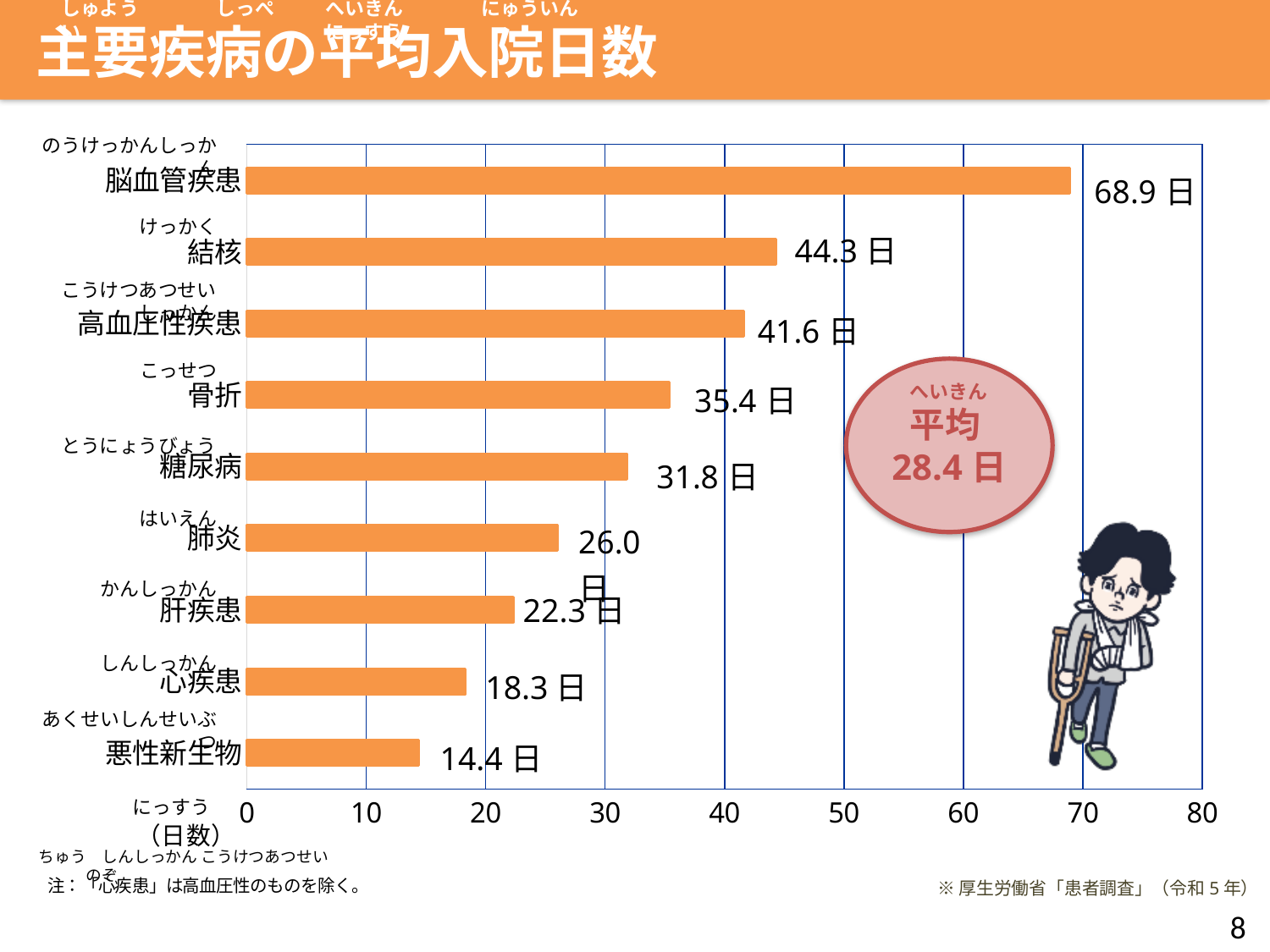
How many diseases are shown in the chart? 9 What is the average number of hospitalization days for 脳血管疾患? 68.9 日 What is the value shown for 骨折? 35.4 日 Which has a higher value, 糖尿病 or 肺炎? 糖尿病 What is the overall average (平均) shown in the circle on the chart? 28.4 日 Is the value for 心疾患 greater or less than 20? less What is the value shown for 悪性新生物? 14.4 日 What is the difference in days between 結核 and 高血圧性疾患? 2.7 日 Which disease has the shortest average hospitalization? 悪性新生物 Which disease has the longest average hospitalization? 脳血管疾患 What kind of chart is shown on the slide? bar chart What is the title of the chart? 主要疾病の平均入院日数